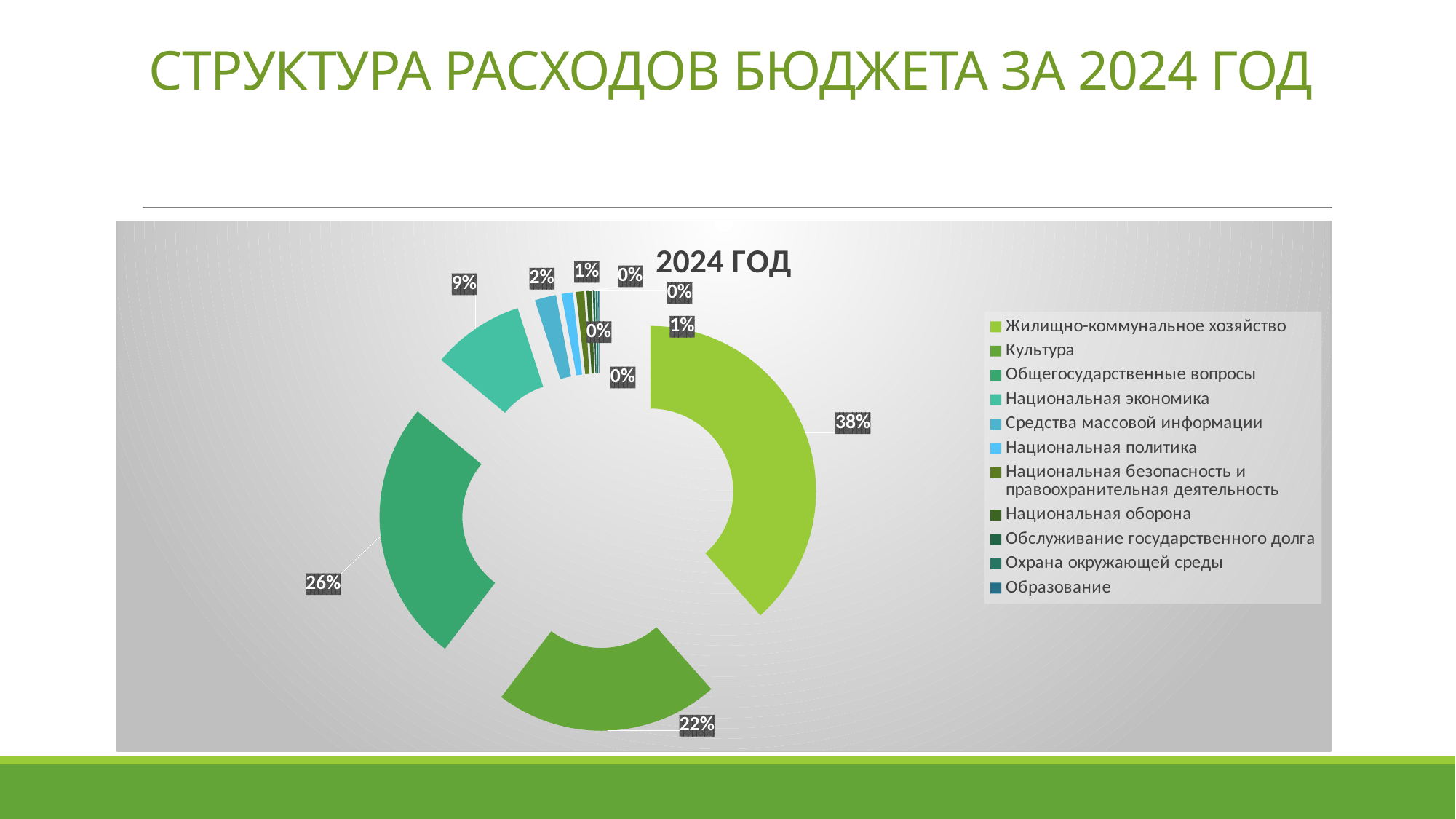
What is the difference in percentage points between Общегосударственные вопросы and Культура? 4 Which is larger: the share for Общегосударственные вопросы or for Национальная экономика? Общегосударственные вопросы What percentage is shown for Общегосударственные вопросы? 26% What kind of chart is shown on the slide? Doughnut (pie) chart How many categories does the legend list? 11 What percentage is shown for Культура? 22% Which category has the largest share of expenditure? Жилищно-коммунальное хозяйство What is the difference in percentage points between Жилищно-коммунальное хозяйство and Культура? 16 What share of the 2024 budget expenditure goes to Жилищно-коммунальное хозяйство? 38% What share does Национальная экономика have in the chart? 9% What percentage is shown for Средства массовой информации? 2% What is the title shown above the chart? 2024 ГОД